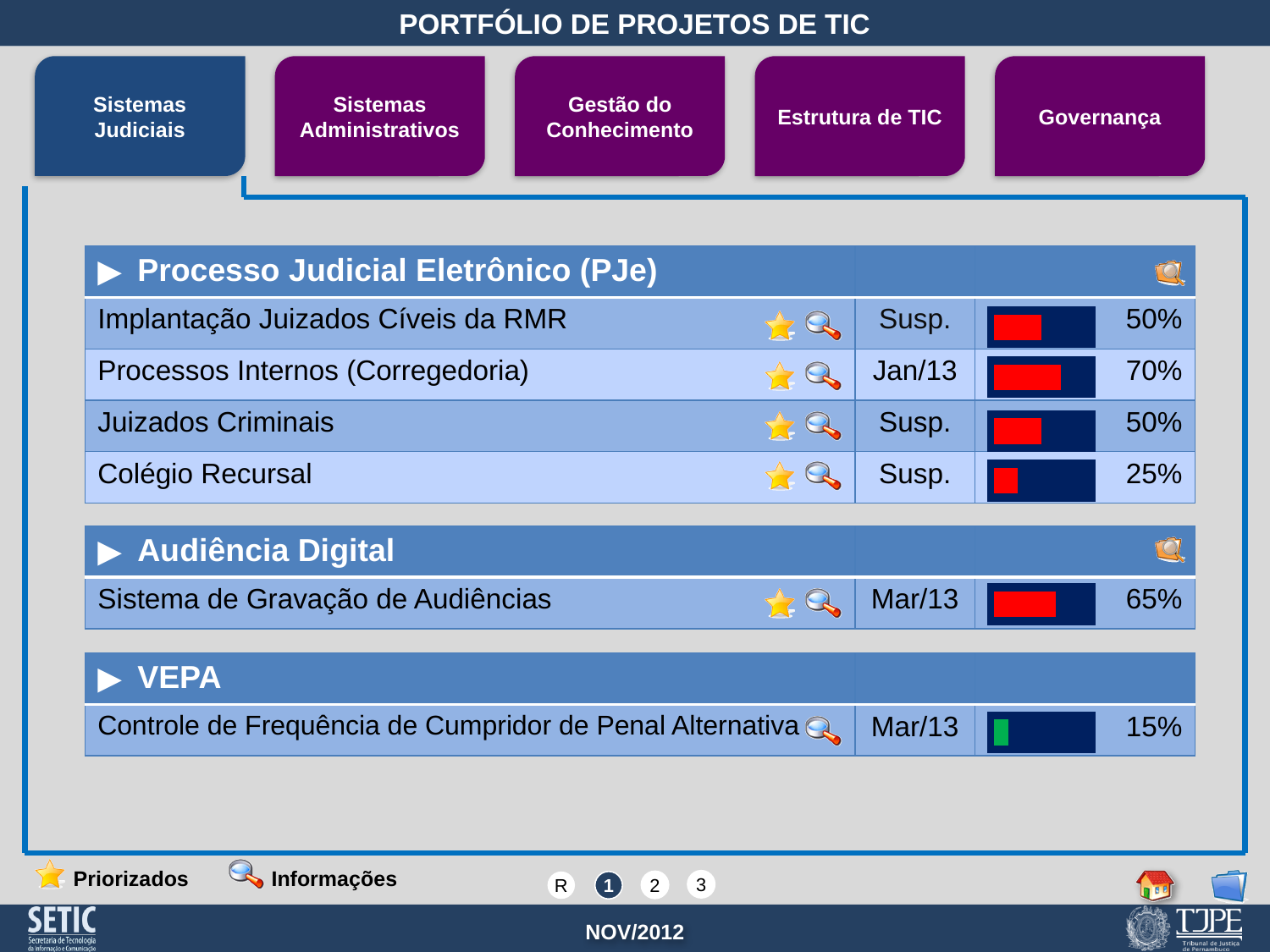
How many projects with progress bars are shown on the slide in total? 6 What is the difference in completion percentage between Processos Internos (Corregedoria) and Colégio Recursal? 45% What is the completion percentage shown for Sistema de Gravação de Audiências? 65% Which project has the lowest completion percentage on the slide? Controle de Frequência de Cumpridor de Penal Alternativa What is the completion percentage shown for Implantação Juizados Cíveis da RMR? 50% Which project has the highest completion percentage on the slide? Processos Internos (Corregedoria) What colour is the progress bar for Controle de Frequência de Cumpridor de Penal Alternativa? Green What is the completion percentage shown for Controle de Frequência de Cumpridor de Penal Alternativa? 15% What is the completion percentage shown for Processos Internos (Corregedoria)? 70% How many projects with progress bars are listed under Processo Judicial Eletrônico (PJe)? 4 Which has a higher completion percentage, Sistema de Gravação de Audiências or Juizados Criminais? Sistema de Gravação de Audiências What is the completion percentage shown for Colégio Recursal? 25%